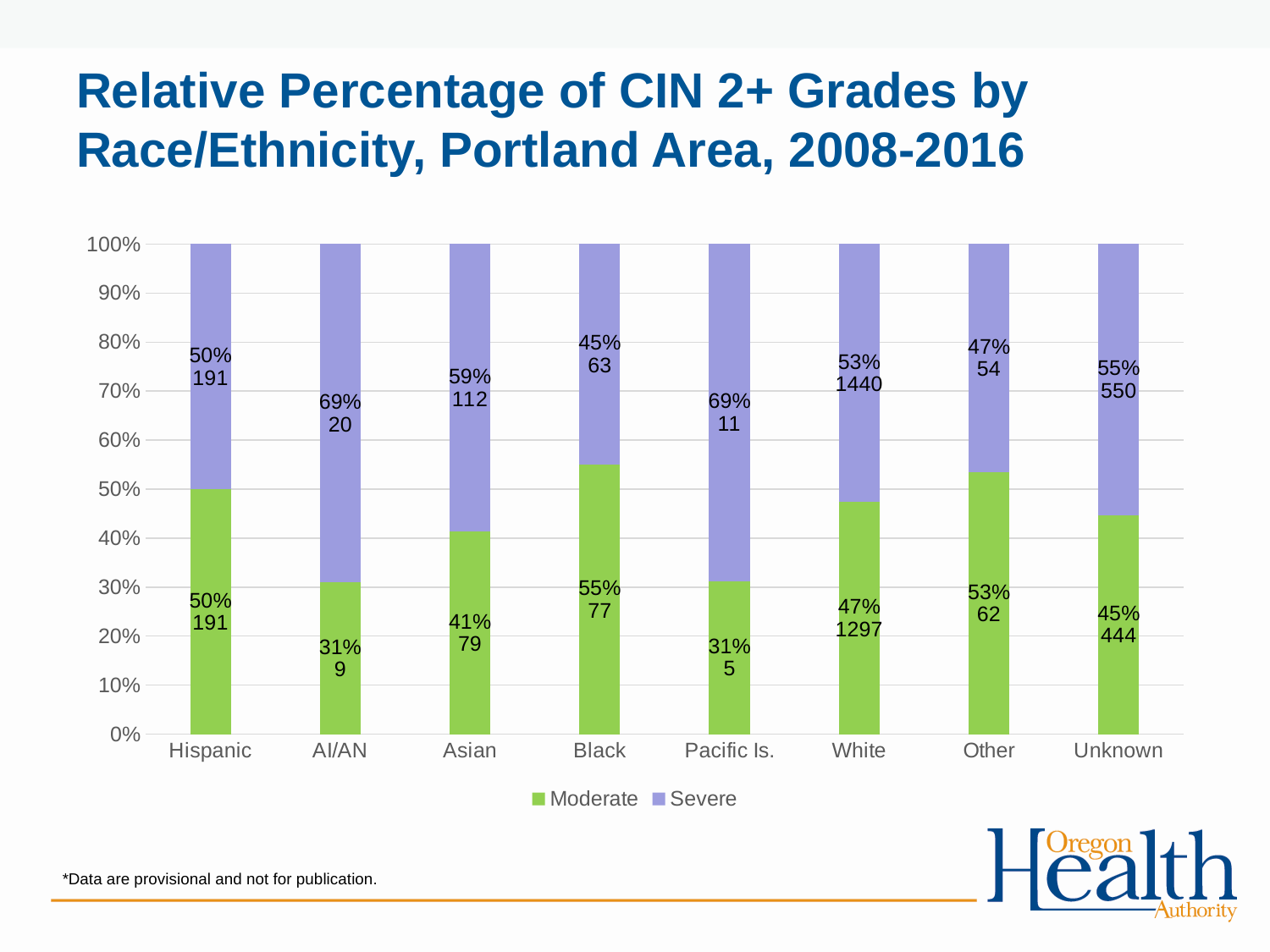
What percentage of CIN 2+ grades for AI/AN are Severe? 69% What is the count shown for Severe grades in the Unknown category? 550 Which colour represents the Severe series in the chart? Purple How many series does the legend list? 2 Which race/ethnicity category has the lowest Severe percentage? Black Which is larger for Other: the Moderate percentage or the Severe percentage? Moderate What kind of chart is shown on the slide? Stacked bar chart Which race/ethnicity category has the highest Moderate percentage? Black What is the total count of Moderate and Severe grades for Hispanic? 382 What is the difference between the Severe percentage and the Moderate percentage for Asian? 18% How many race/ethnicity categories are shown on the x axis? 8 What percentage of CIN 2+ grades for White are Moderate? 47%